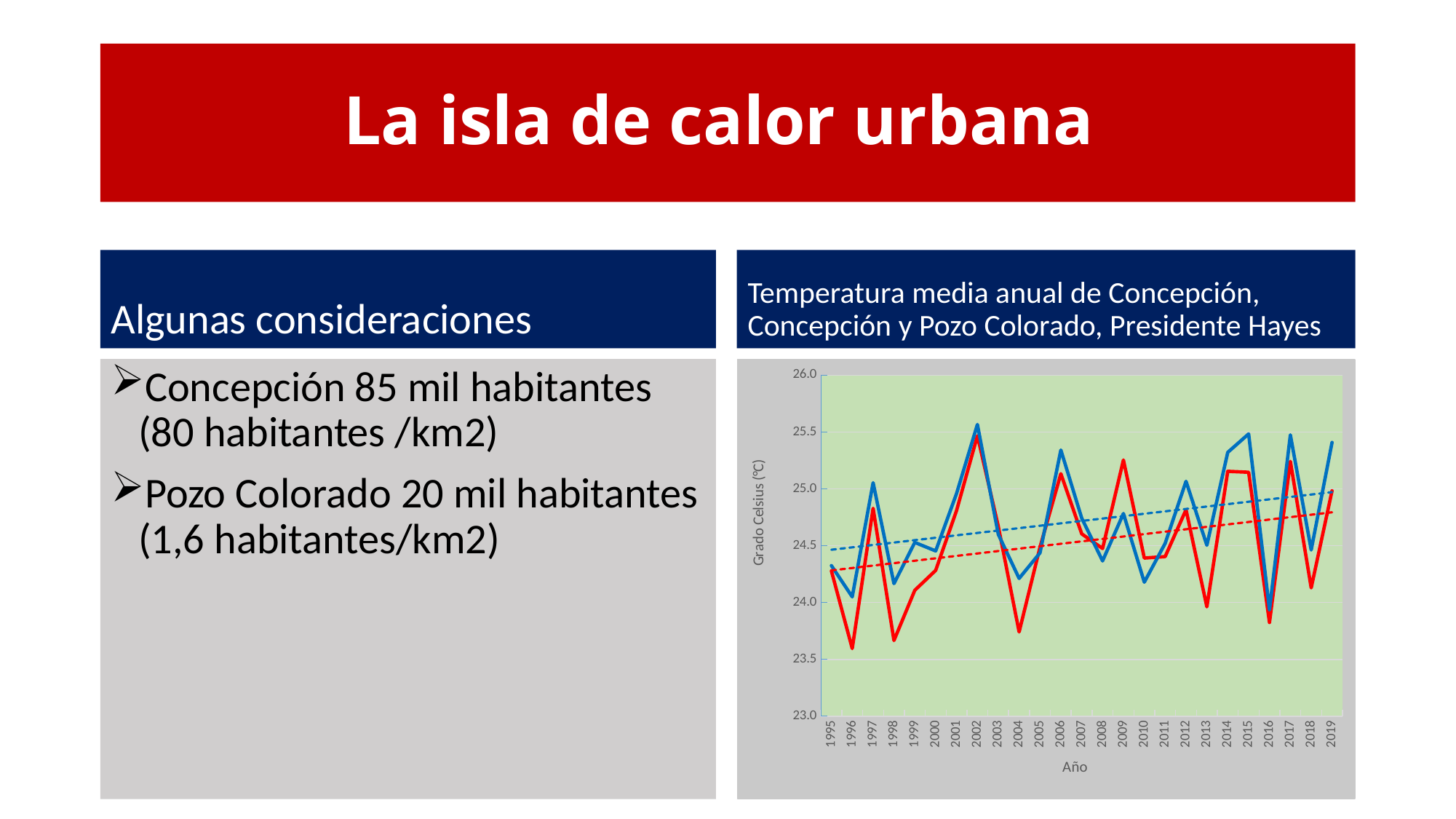
What is the last year shown on the x axis of the chart? 2019 In 2009, which line has the higher value, the blue line or the red line? red line What is the first year shown on the x axis of the chart? 1995 In 1996, which line has the higher value, the blue line or the red line? blue line Is the value of the blue line in 2002 greater or less than 25.0? greater How many years are shown along the x axis of the chart? 25 What is the label of the y axis of the chart? Grado Celsius (°C) Is the value of the blue line in 2015 greater or less than 25.0? greater Do the dashed trend lines in the chart rise or fall from 1995 to 2019? rise Is the value of the red line in 1996 greater or less than 24.0? less What kind of chart is shown on the slide? line chart